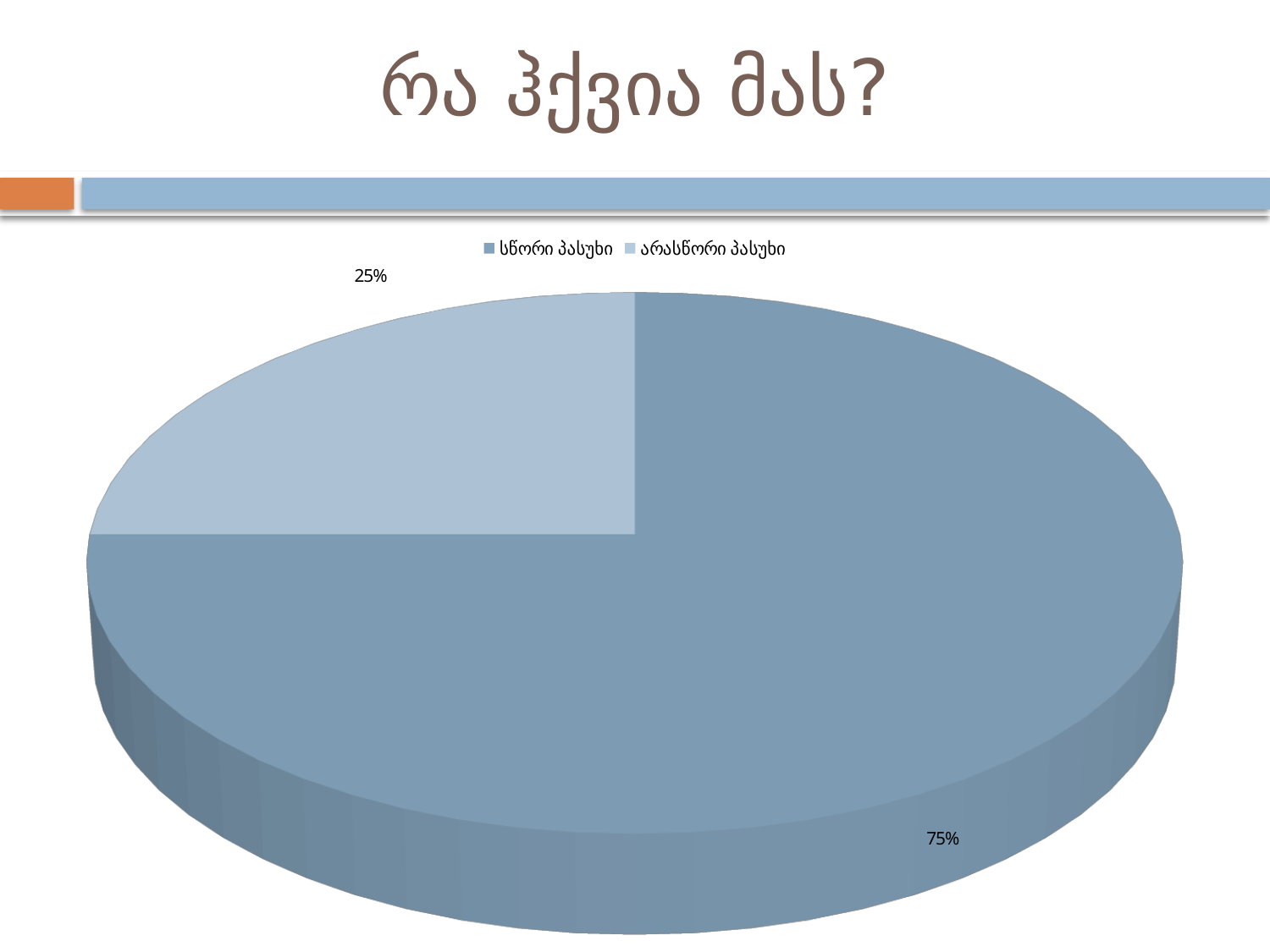
What is the difference in percentage points between the სწორი პასუხი slice and the არასწორი პასუხი slice? 50 Which legend entry is shown in the lighter blue colour? არასწორი პასუხი What percentage of the pie is labelled for სწორი პასუხი? 75% How many entries does the legend list? 2 What share of the pie does the არასწორი პასუხი slice take? 25% Which slice of the pie is the smallest? არასწორი პასუხი What kind of chart is shown on the slide? pie chart Which is larger: the სწორი პასუხი slice or the არასწორი პასუხი slice? სწორი პასუხი How many slices does the pie chart have? 2 What is the title of the slide containing the pie chart? რა ჰქვია მას? Which slice of the pie is the largest? სწორი პასუხი What percentage of the pie is labelled for არასწორი პასუხი? 25%